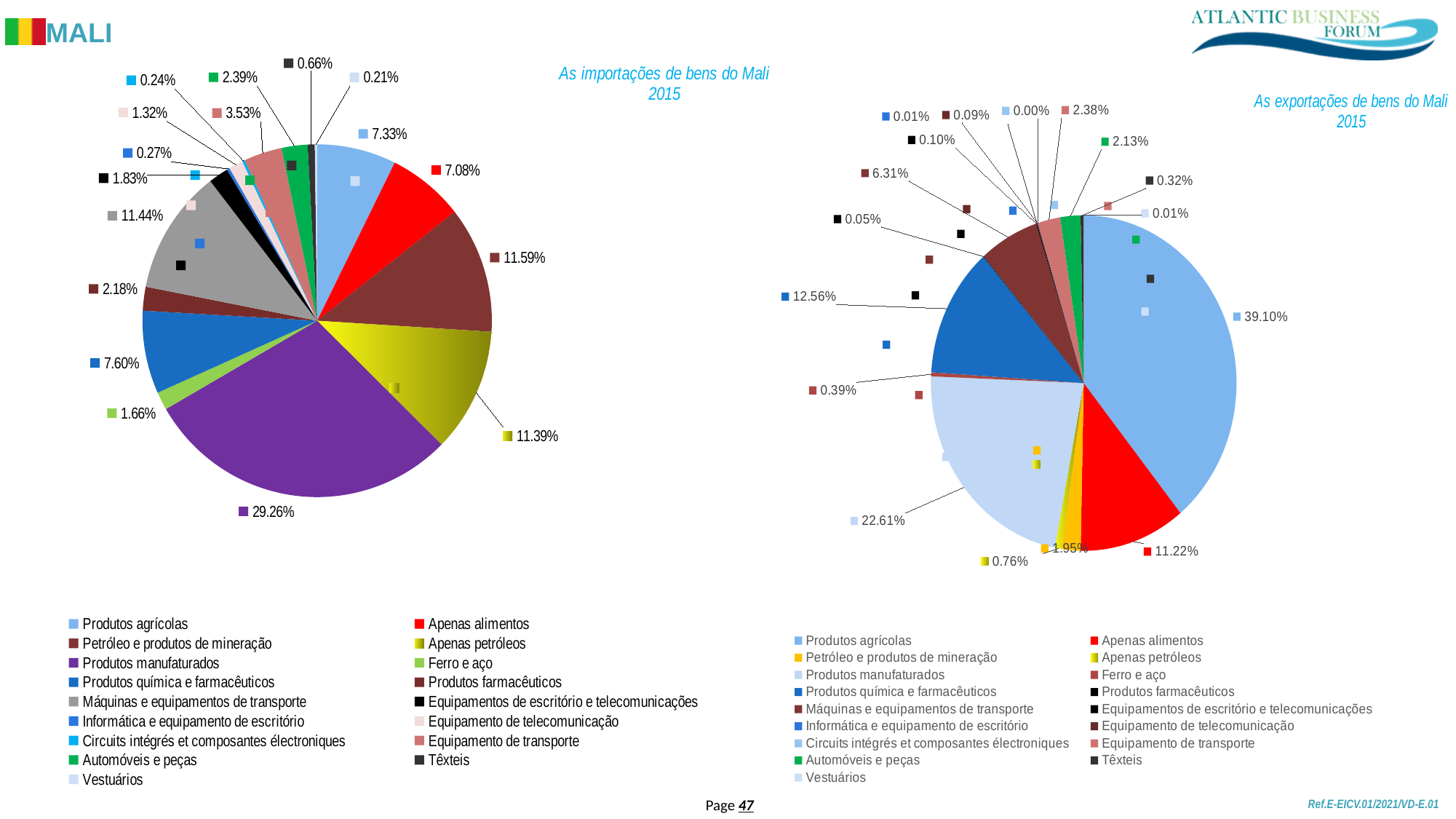
In the 'As exportações de bens do Mali 2015' chart, what share is shown for Produtos manufaturados? 22.61% In the 'As importações de bens do Mali 2015' chart, what share is shown for Produtos manufaturados? 29.26% In the 'As exportações de bens do Mali 2015' chart, what share is shown for Produtos agrícolas? 39.10% What kind of chart is 'As importações de bens do Mali 2015'? pie chart In the 'As importações de bens do Mali 2015' chart, what is the difference between the shares of Produtos agrícolas (7.33%) and Apenas alimentos (7.08%)? 0.25% Which chart is on the left side of the slide? As importações de bens do Mali 2015 How many categories does the legend of the 'As exportações de bens do Mali 2015' chart list? 17 In the 'As exportações de bens do Mali 2015' chart, what is the difference between the shares of Produtos química e farmacêuticos (12.56%) and Apenas alimentos (11.22%)? 1.34% In the 'As importações de bens do Mali 2015' chart, what share is shown for Apenas petróleos? 11.39% In the 'As importações de bens do Mali 2015' chart, which category has the largest share? Produtos manufaturados In the 'As exportações de bens do Mali 2015' chart, which category has the largest share? Produtos agrícolas In the 'As importações de bens do Mali 2015' chart, which is larger: Petróleo e produtos de mineração or Máquinas e equipamentos de transporte? Petróleo e produtos de mineração